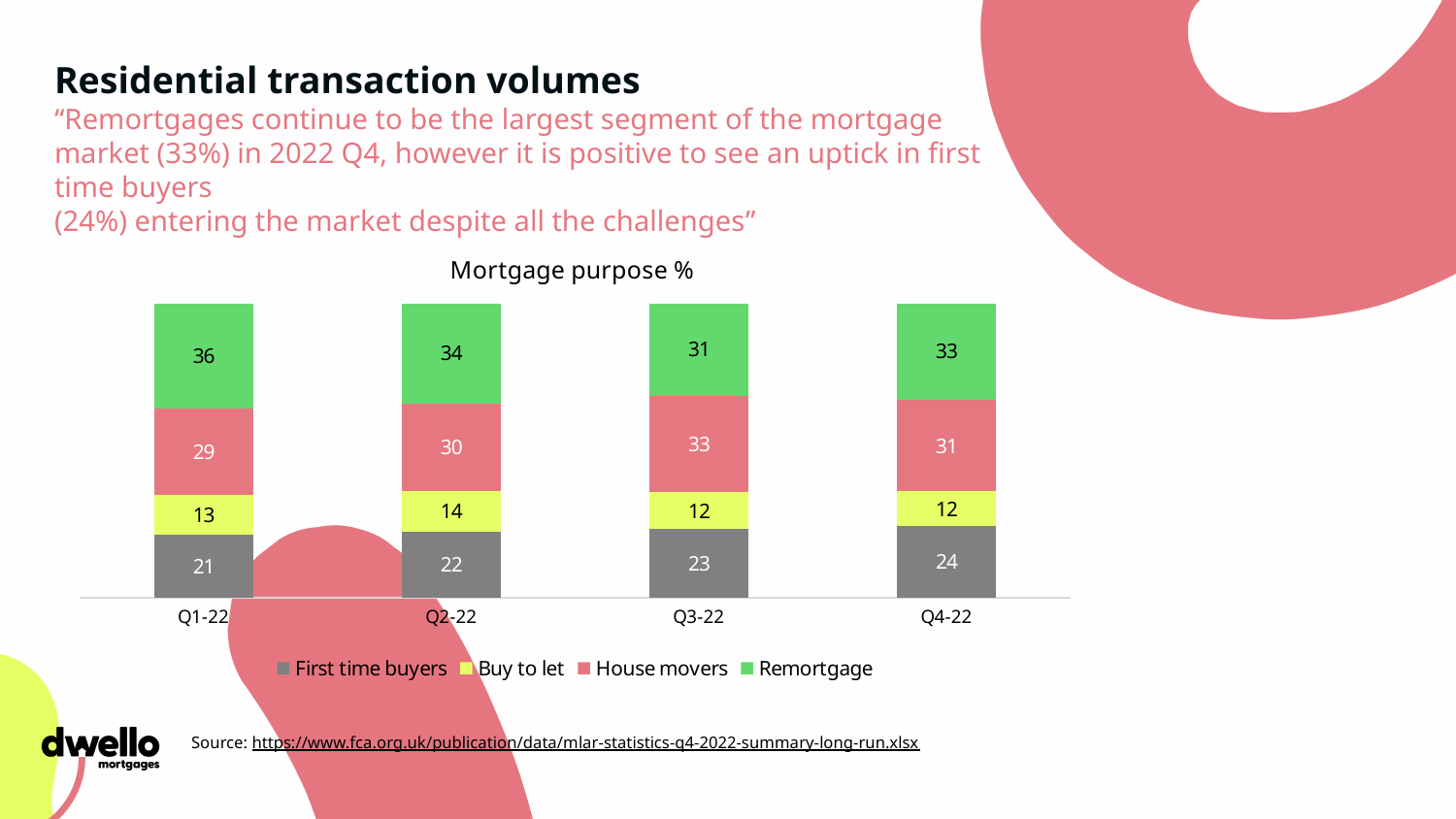
In which quarter is the Remortgage value highest? Q1-22 What is the value for Buy to let in Q2-22? 14 In which quarter is the First time buyers value lowest? Q1-22 Which is larger in Q3-22: House movers or Remortgage? House movers What is the difference between the Remortgage values in Q1-22 and Q3-22? 5 How many series does the legend list? 4 Do the First time buyers values rise or fall from Q1-22 to Q4-22? Rise What is the value for House movers in Q3-22? 33 What is the value for First time buyers in Q4-22? 24 What is the value for Remortgage in Q1-22? 36 What kind of chart is shown on the slide? Stacked bar chart How many quarters are shown on the x axis? 4